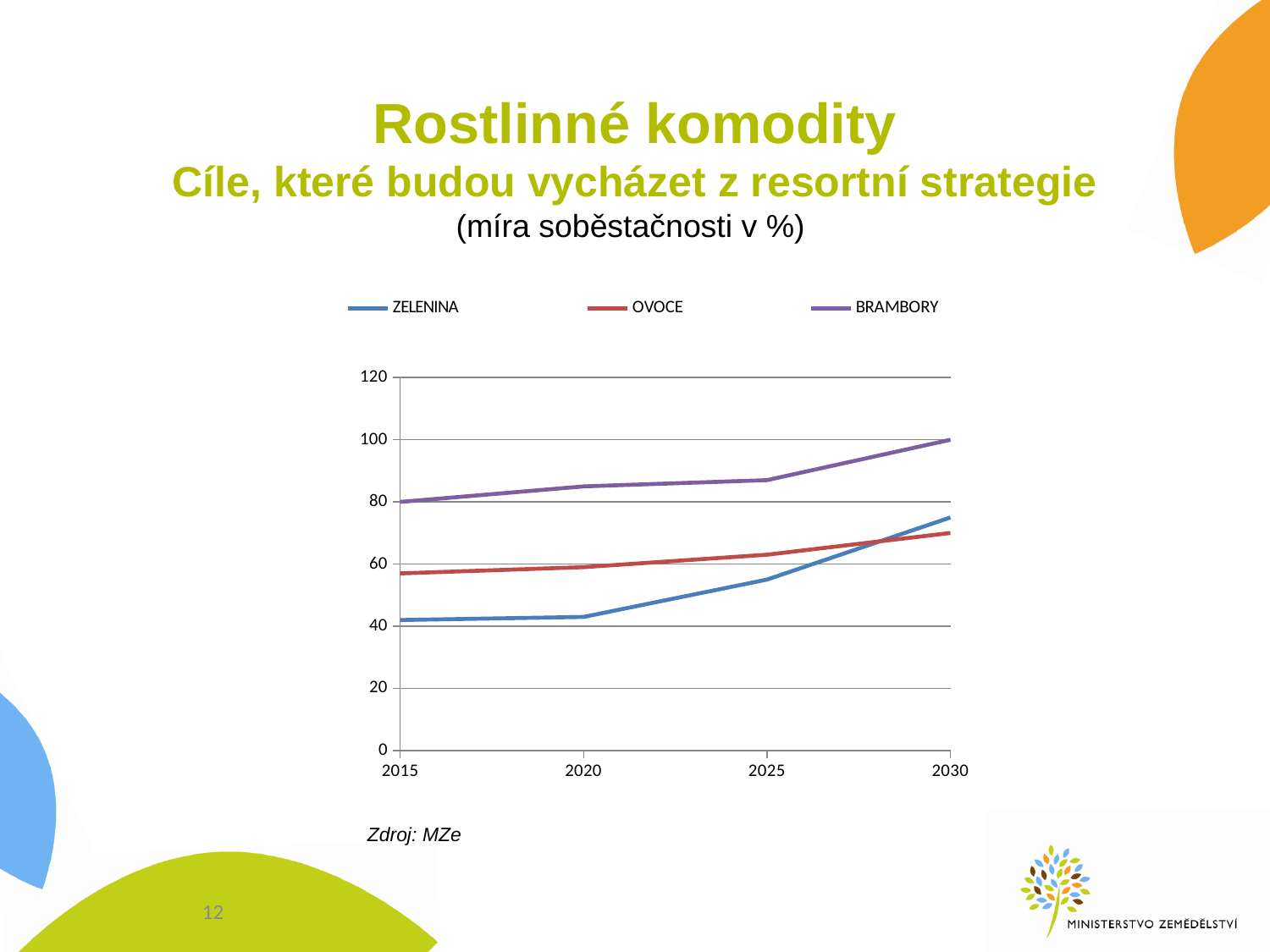
What is the value for BRAMBORY in 2015? 80 How many series does the legend list? 3 What kind of chart is shown on the slide? line chart What is the value for BRAMBORY in 2030? 100 Which is larger in 2030, ZELENINA or OVOCE? ZELENINA Which colour is used for the OVOCE series? red How many years are marked on the x axis? 4 Does the ZELENINA series rise or fall from 2015 to 2030? rise Which series has the lowest value in 2020? ZELENINA Is the value for ZELENINA in 2015 greater or less than 60? less Which series has the highest value in 2015? BRAMBORY Is the value for OVOCE in 2030 greater or less than 60? greater